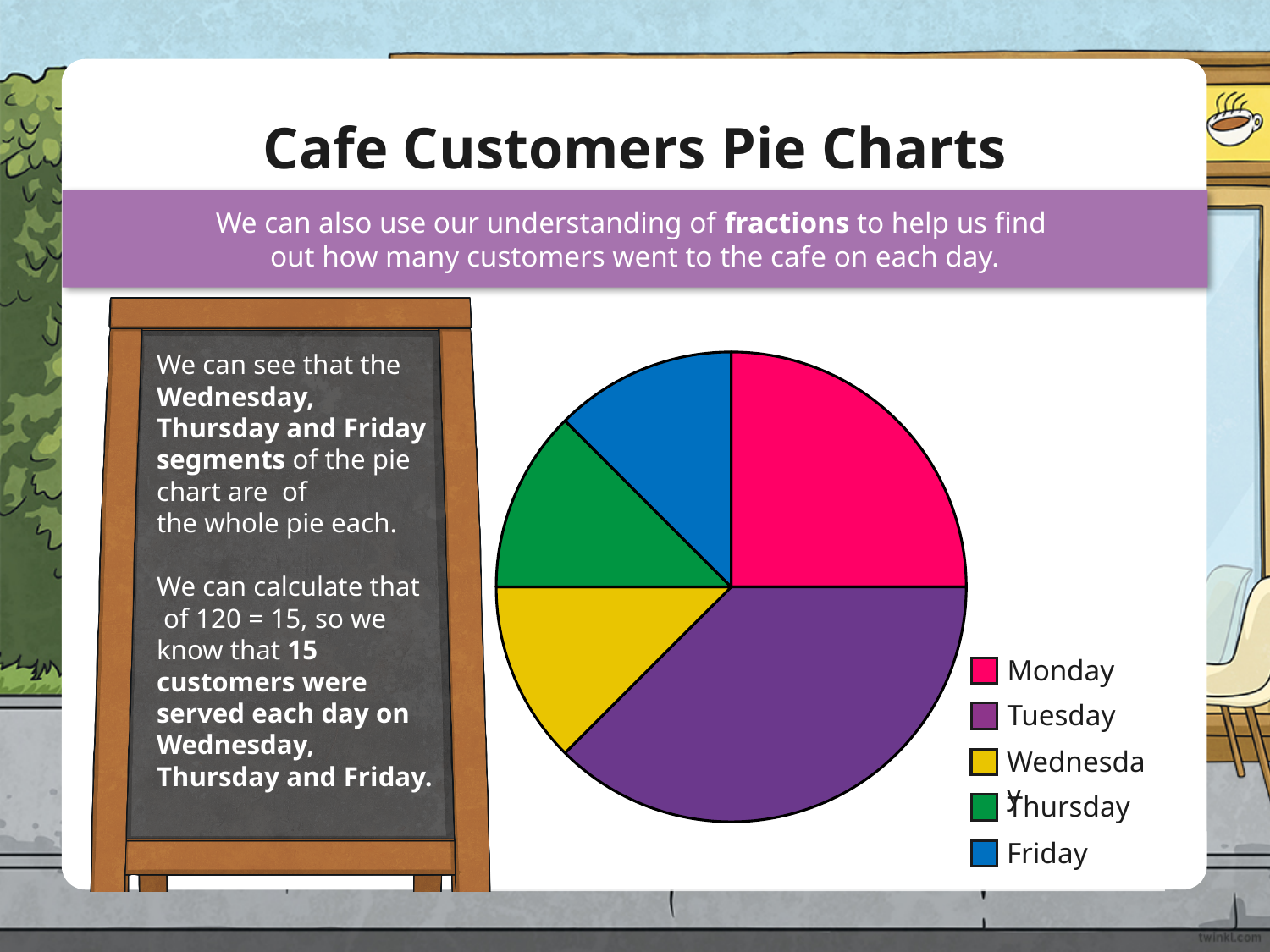
What is the total number of customers the pie chart represents, according to the slide text? 120 How many entries does the legend of the pie chart list? 5 According to the slide, how many customers were served on Friday? 15 How many slices does the pie chart have? 5 According to the slide, how many customers were served on Wednesday? 15 Which day has the largest slice of the pie chart? Tuesday Which slice is larger, Tuesday or Friday? Tuesday Which slice is larger, Tuesday or Monday? Tuesday Which slice is larger, Monday or Wednesday? Monday Which day is shown in green in the pie chart legend? Thursday What kind of chart is shown on the slide? pie chart What colour is the Monday slice in the pie chart? pink